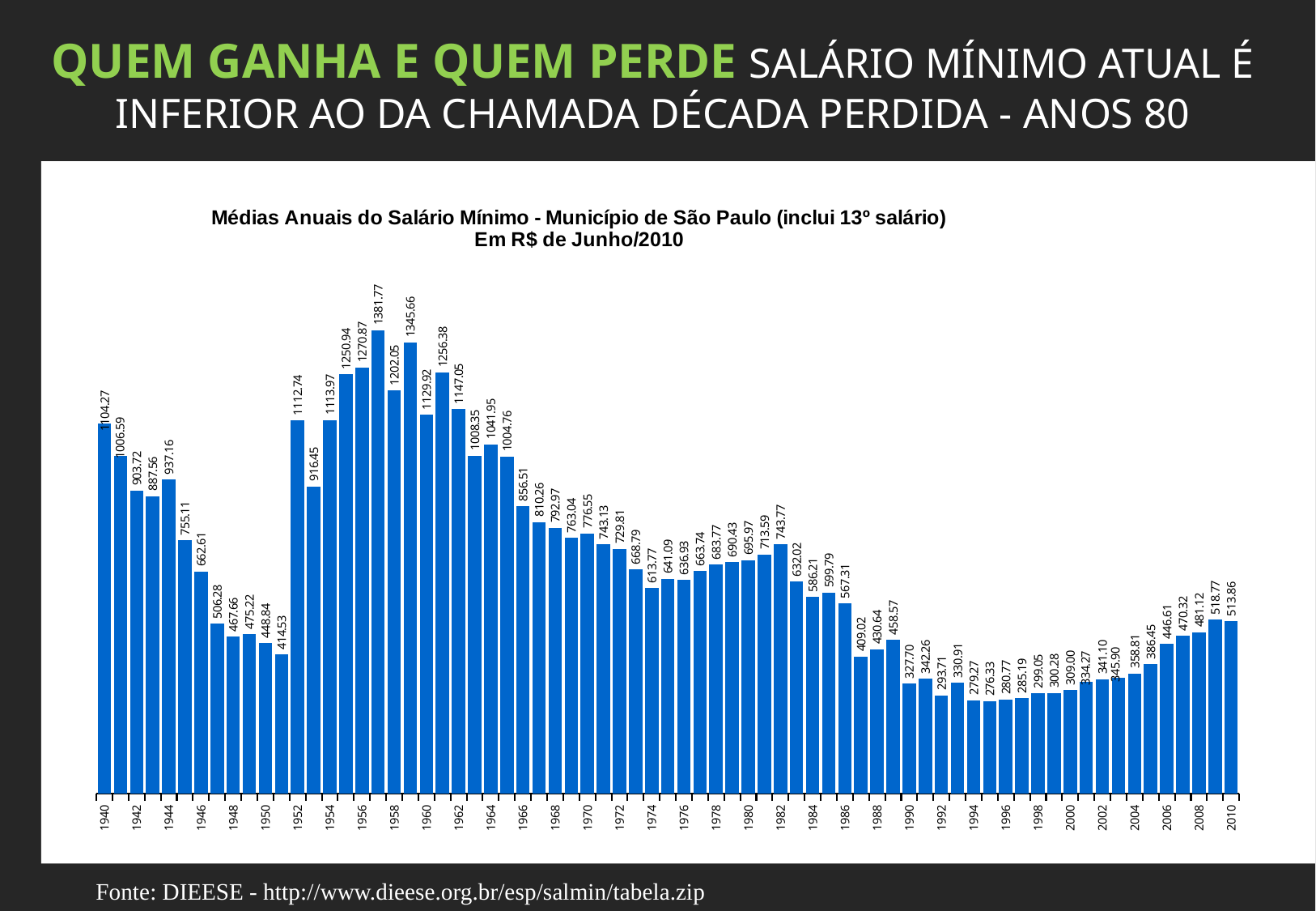
Do the values rise or fall from 1966 to 1974? fall What is the value for 1940? 1104.27 What is the value for 1960? 1129.92 What is the value for 2010? 513.86 What is the value for 1980? 695.97 What is the difference between the value for 1940 and the value for 2010? 590.41 What is the difference between the value for 2008 and the value for 2006? 34.51 Which year has the larger value, 1982 or 1984? 1982 What is the title of the chart? Médias Anuais do Salário Mínimo - Município de São Paulo (inclui 13º salário) Em R$ de Junho/2010 What kind of chart is shown on the slide? bar chart What is the lowest value shown in the chart? 276.33 What is the highest value shown in the chart? 1381.77